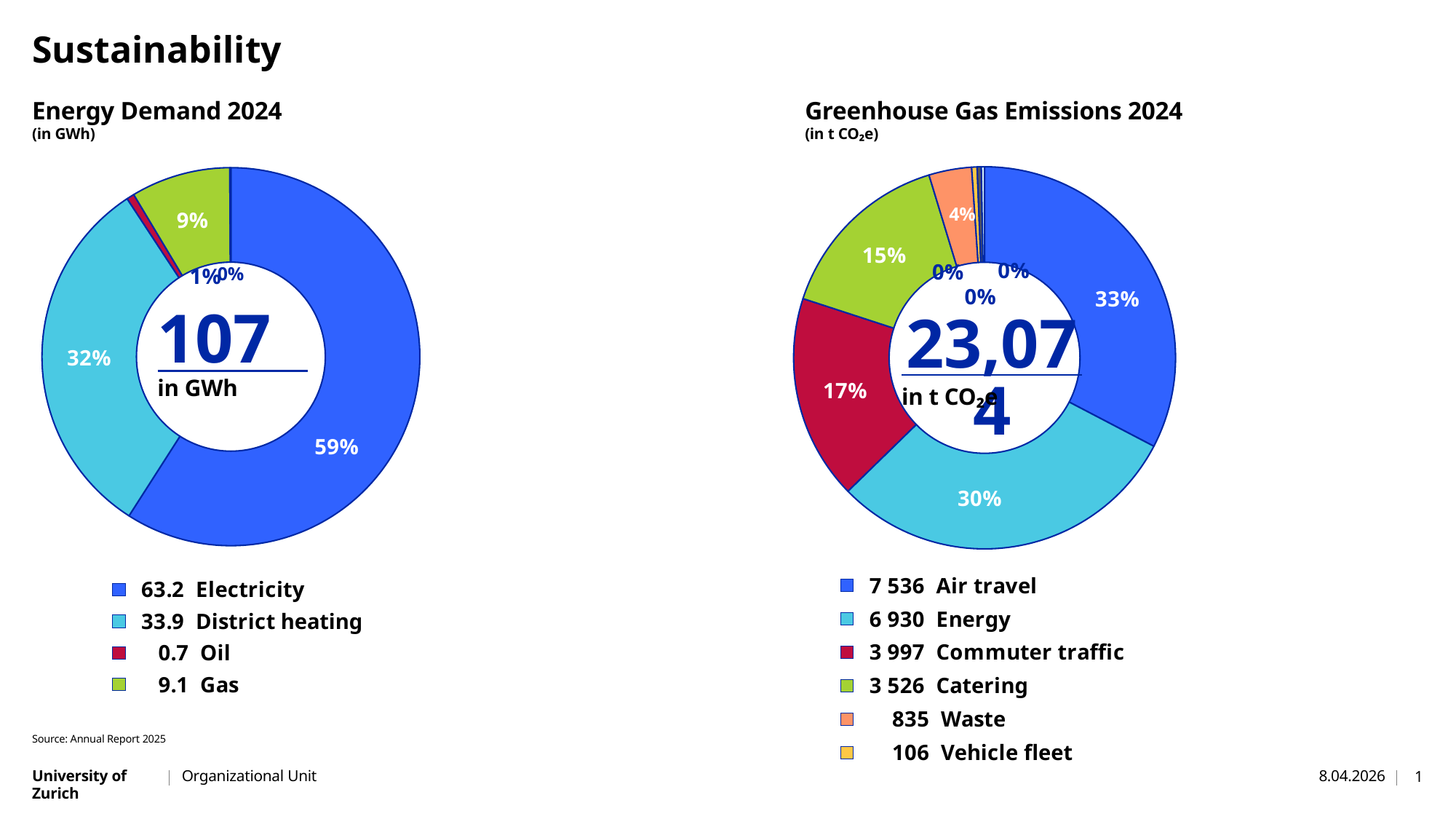
In the Energy Demand 2024 chart, what share of the total does Electricity account for? 59% How many categories does the legend of the Greenhouse Gas Emissions 2024 chart list? 6 In the Greenhouse Gas Emissions 2024 chart, what share of the total does Energy account for? 30% In the Energy Demand 2024 chart, what is the value for District heating? 33.9 In the Greenhouse Gas Emissions 2024 chart, which category has the highest value? Air travel In the Energy Demand 2024 chart, what is the difference between Electricity and District heating? 29.3 In the Greenhouse Gas Emissions 2024 chart, which is larger, Catering or Waste? Catering What kind of chart is the Greenhouse Gas Emissions 2024 chart? Donut (pie) chart In the Energy Demand 2024 chart, what is the value for Electricity? 63.2 In the Greenhouse Gas Emissions 2024 chart, what is the value for Commuter traffic? 3 997 In the Energy Demand 2024 chart, what total value is shown in the centre of the donut? 107